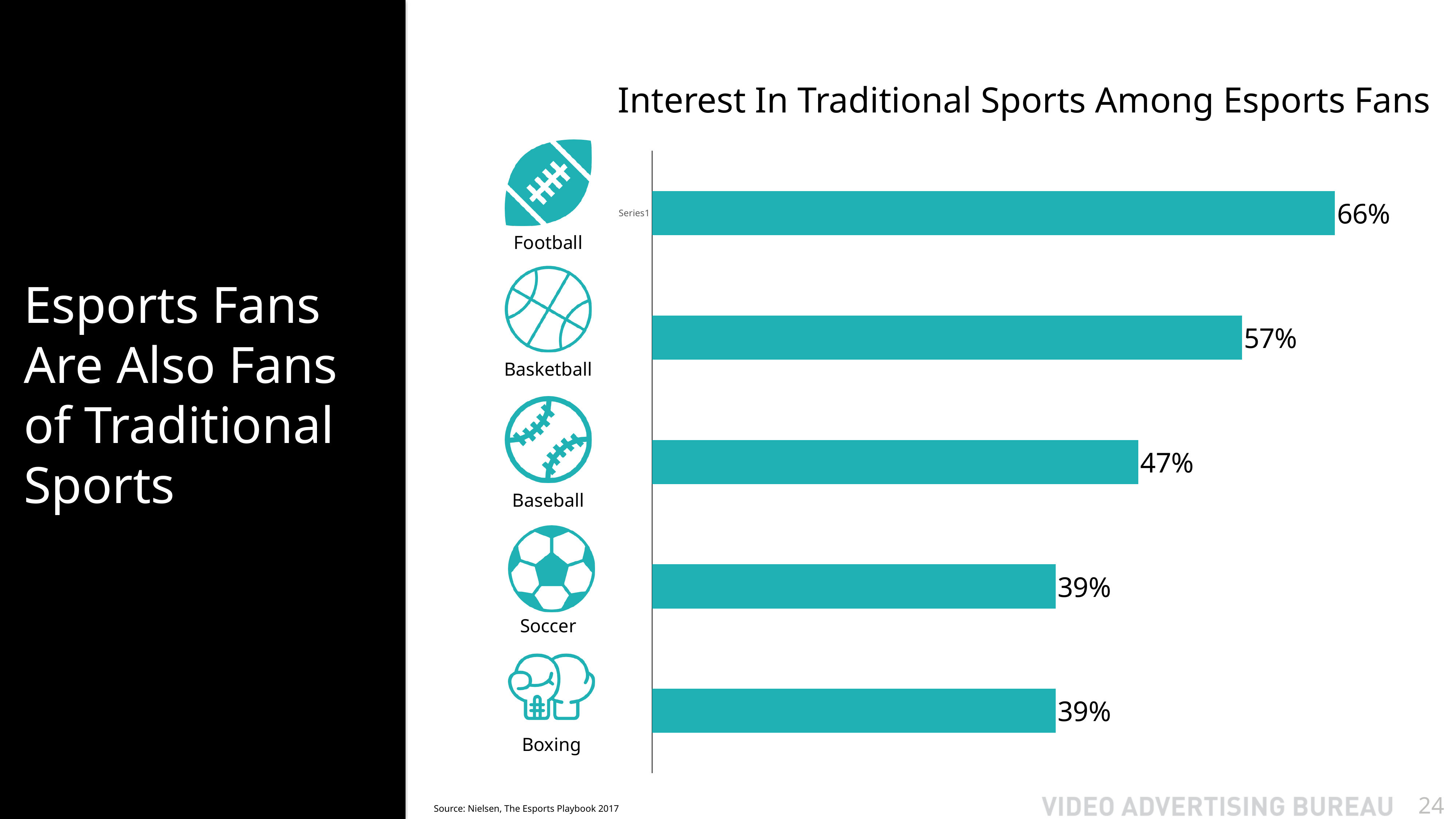
What is the value shown for soccer? 39% What is the value shown for basketball? 57% Which sport has the highest interest among esports fans? Football What percentage of esports fans are interested in football? 66% Which two sports share the same value of 39%? Soccer and Boxing What is the value shown for baseball? 47% What is the difference between the football and basketball values? 9% How many sports are shown in the chart? 5 What is the title of the chart? Interest In Traditional Sports Among Esports Fans What kind of chart is shown on the slide? Bar chart Which has a larger value, baseball or soccer? Baseball What is the difference between the basketball and baseball values? 10%